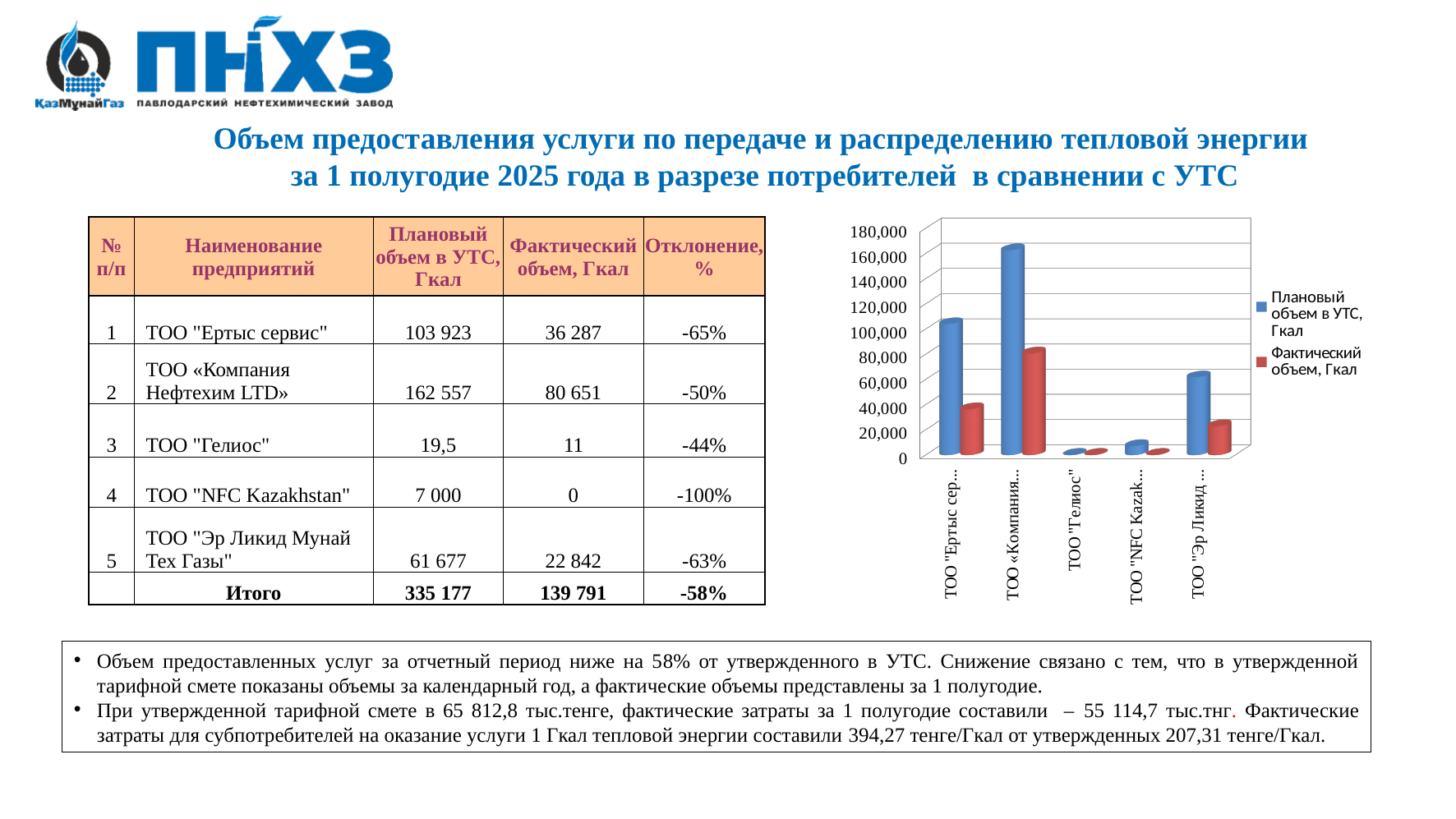
What is the actual volume (Фактический объем, Гкал) for ТОО "Эр Ликид Мунай Тех Газы"? 22 842 Is the actual volume (Фактический объем) for ТОО "Эр Ликид Мунай Тех Газы" greater or less than 40,000? less What colour represents the series "Фактический объем, Гкал" in the chart? red What kind of chart is shown on the slide? bar chart Is the planned volume (Плановый объем в УТС) for ТОО "Ертыс сервис" greater or less than 80,000? greater Which enterprise has the highest actual volume (Фактический объем) in the chart? ТОО «Компания Нефтехим LTD» How many enterprises (categories) are plotted on the x axis of the chart? 5 Which enterprise has the lowest planned volume (Плановый объем в УТС) in the chart? ТОО "Гелиос" Which enterprise has the highest planned volume (Плановый объем в УТС) in the chart? ТОО «Компания Нефтехим LTD» What is the difference between the planned and actual volume for ТОО "Ертыс сервис" in Гкал? 67 636 For ТОО "Ертыс сервис", which is larger: the planned volume or the actual volume? planned volume How many series does the chart legend list? 2